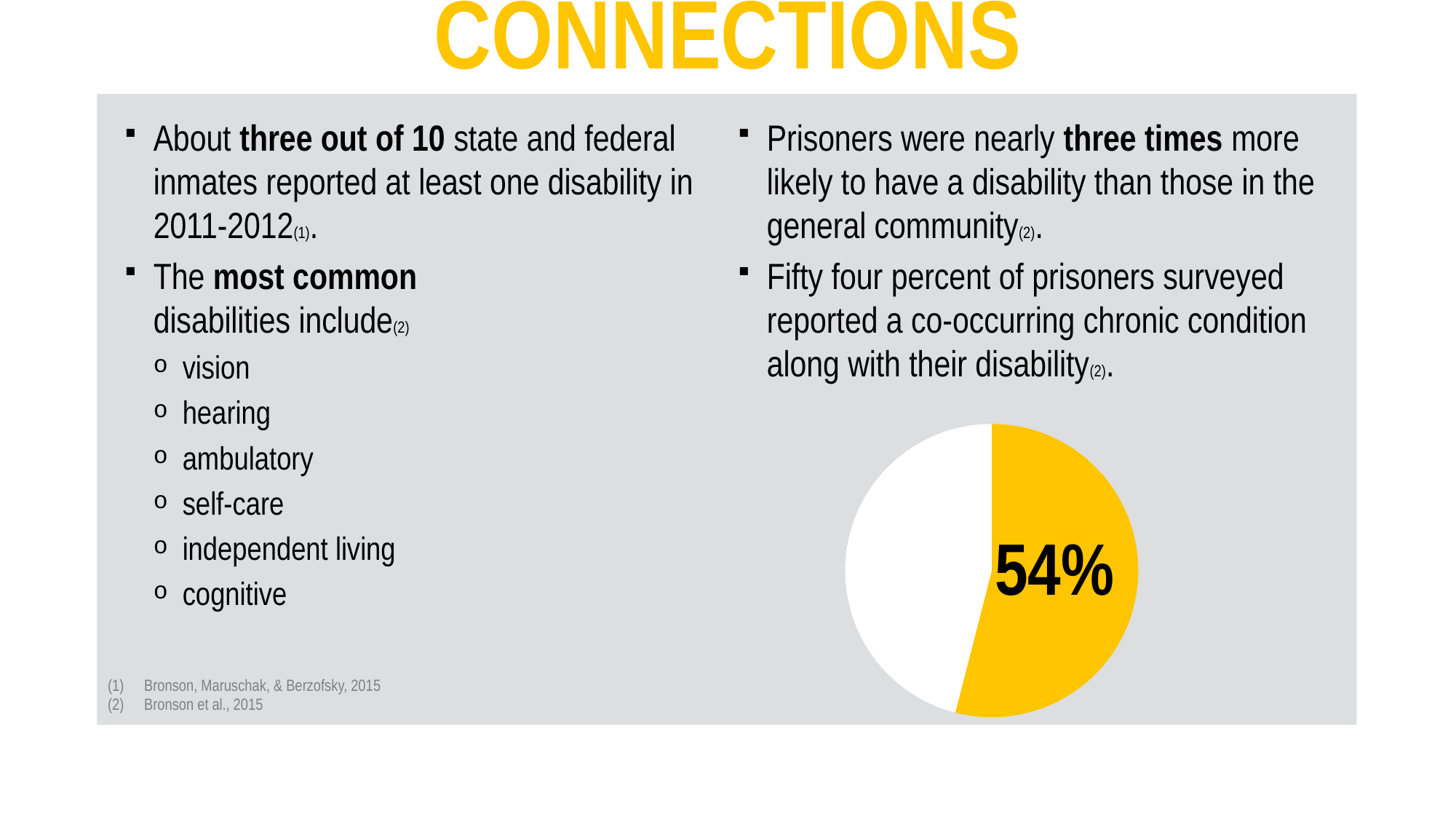
How many slices does the pie chart have? 2 Which slice of the pie chart is larger, the yellow one or the white one? yellow What colour is the slice of the pie chart that carries the 54% label? yellow Does the pie chart have a legend? No Is the yellow slice of the pie chart greater or less than half of the pie? greater What share of the pie chart does the white slice represent? 46% What kind of chart is shown on the slide? pie chart What percentage is printed on the yellow slice of the pie chart? 54%